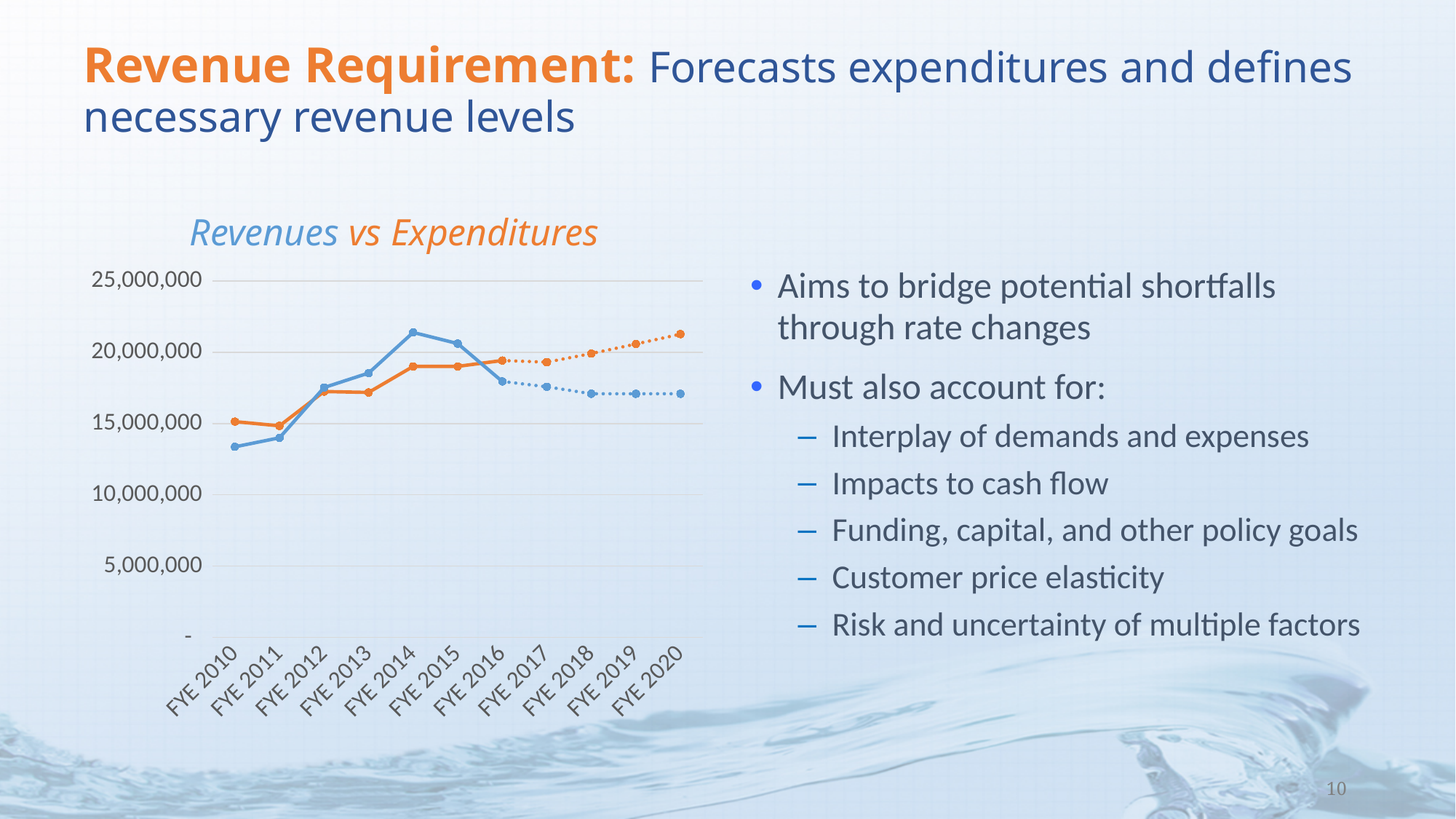
What kind of chart is shown on the slide? Line chart Is the Revenues value for FYE 2014 greater or less than 20,000,000? greater Do Expenditures rise or fall from FYE 2016 to FYE 2020? Rise Is the Expenditures value for FYE 2020 greater or less than 20,000,000? greater In which fiscal year is the Revenues value lowest? FYE 2010 In which fiscal year does the Revenues line reach its highest value? FYE 2014 How many fiscal years (FYE categories) are shown on the x axis of the chart? 11 What is the title of the chart? Revenues vs Expenditures In which fiscal year does the Expenditures line reach its highest value? FYE 2020 Is the Revenues value for FYE 2010 greater or less than 15,000,000? less How many data series are plotted in the chart? 4 In FYE 2014, which is larger, Revenues or Expenditures? Revenues